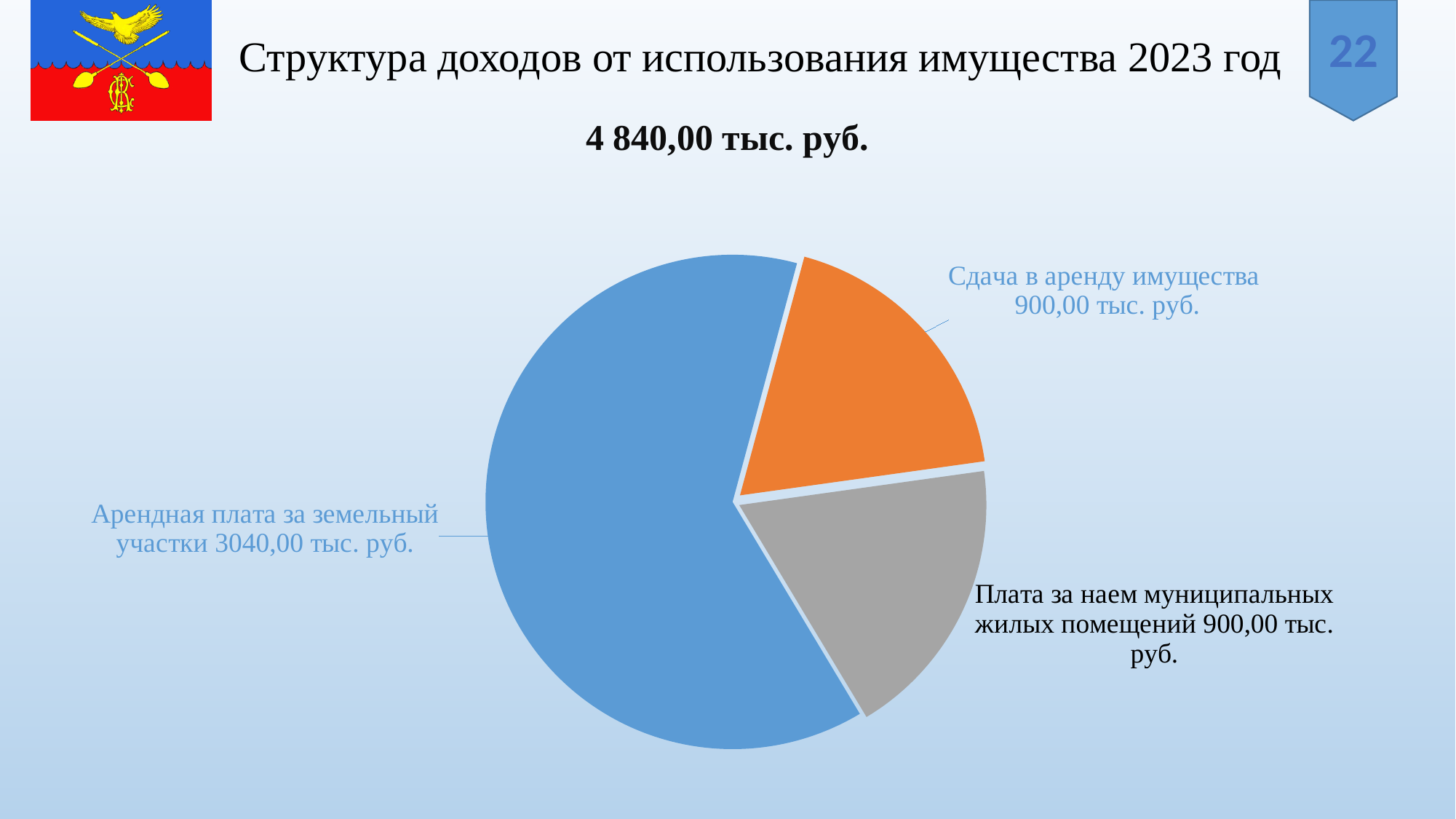
Which is larger: Арендная плата за земельный участки or Сдача в аренду имущества? Арендная плата за земельный участки What is the title of the slide? Структура доходов от использования имущества 2023 год What is the difference between Арендная плата за земельный участки and Сдача в аренду имущества? 2140,00 тыс. руб. What kind of chart is shown on the slide? Pie chart What is the total of all slices shown on the slide? 4 840,00 тыс. руб. Which category has the largest slice of the pie? Арендная плата за земельный участки What is the value for Плата за наем муниципальных жилых помещений? 900,00 тыс. руб. How many slices does the pie chart have? 3 What is the value for Арендная плата за земельный участки? 3040,00 тыс. руб. What share of the total does Арендная плата за земельный участки represent? 62.8% What is the value for Сдача в аренду имущества? 900,00 тыс. руб. What colour is the slice for Сдача в аренду имущества? Orange